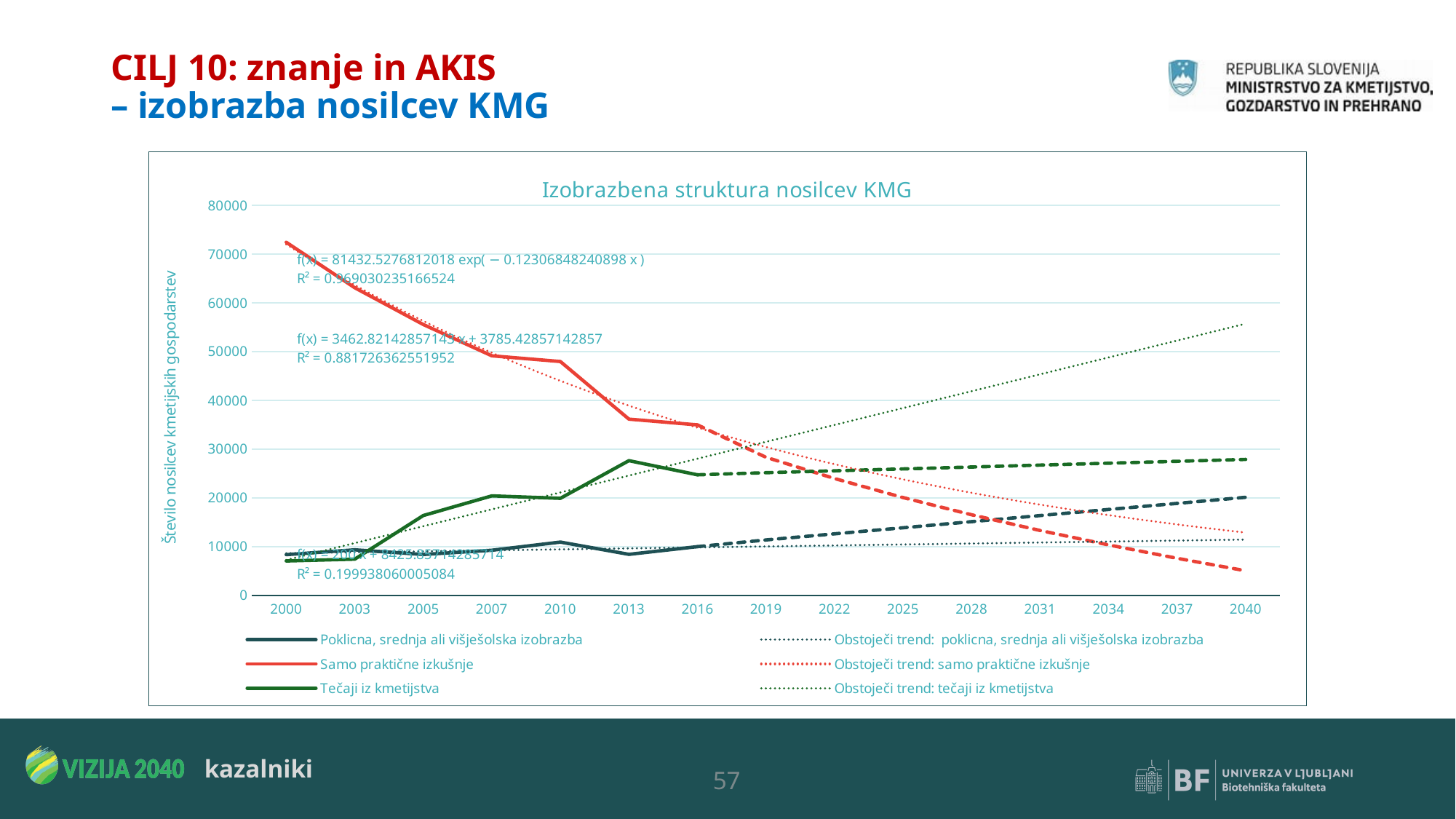
In 2016, which is larger: Tečaji iz kmetijstva or Poklicna, srednja ali višješolska izobrazba? Tečaji iz kmetijstva Is the value for Samo praktične izkušnje in 2016 greater or less than 40000? less What type of chart is shown on the slide? line chart Which series has the highest value in 2000? Samo praktične izkušnje Is the value for Samo praktične izkušnje in 2000 greater or less than 70000? greater Is the value for Tečaji iz kmetijstva in 2013 greater or less than 20000? greater Does the Samo praktične izkušnje series rise or fall from 2000 to 2016? fall How many series does the chart legend list? 6 What is the label of the y axis? Število nosilcev kmetijskih gospodarstev What is the title of the chart? Izobrazbena struktura nosilcev KMG How many year labels are shown on the x axis? 15